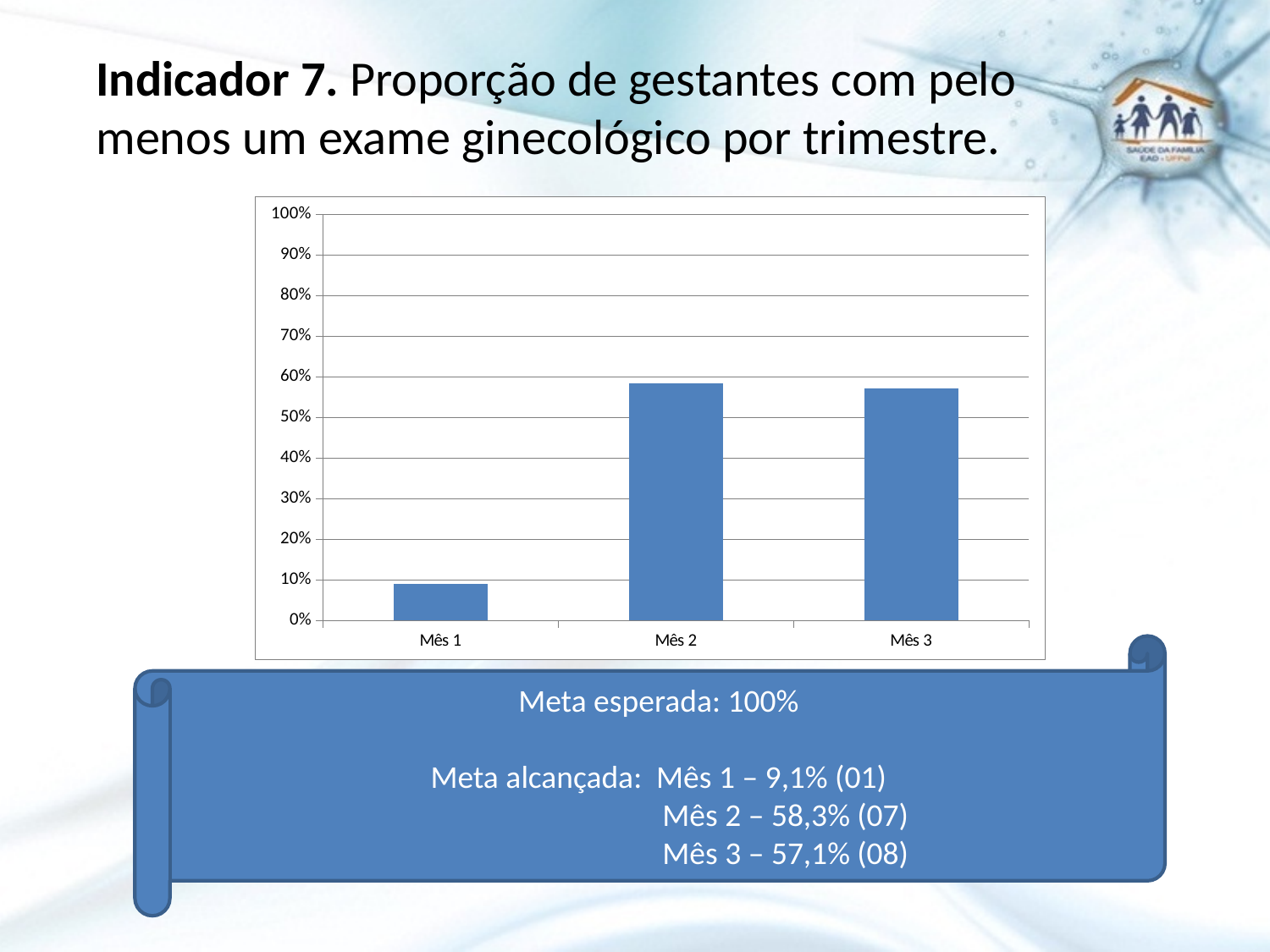
Which month has the highest value in the chart? Mês 2 What is the expected target (meta esperada) stated on the slide? 100% What is the difference between the values for Mês 2 and Mês 1? 49,2% Is the value for Mês 3 greater or less than 60%? less Which month has the lowest bar in the chart? Mês 1 What kind of chart is shown on the slide? bar chart Is the value for Mês 1 greater or less than 20%? less According to the slide, what value was reached for Mês 1? 9,1% How many categories (months) are plotted on the x axis of the chart? 3 According to the slide, what value was reached for Mês 3? 57,1% According to the slide, what value was reached for Mês 2? 58,3% Is the value for Mês 2 greater or less than 50%? greater